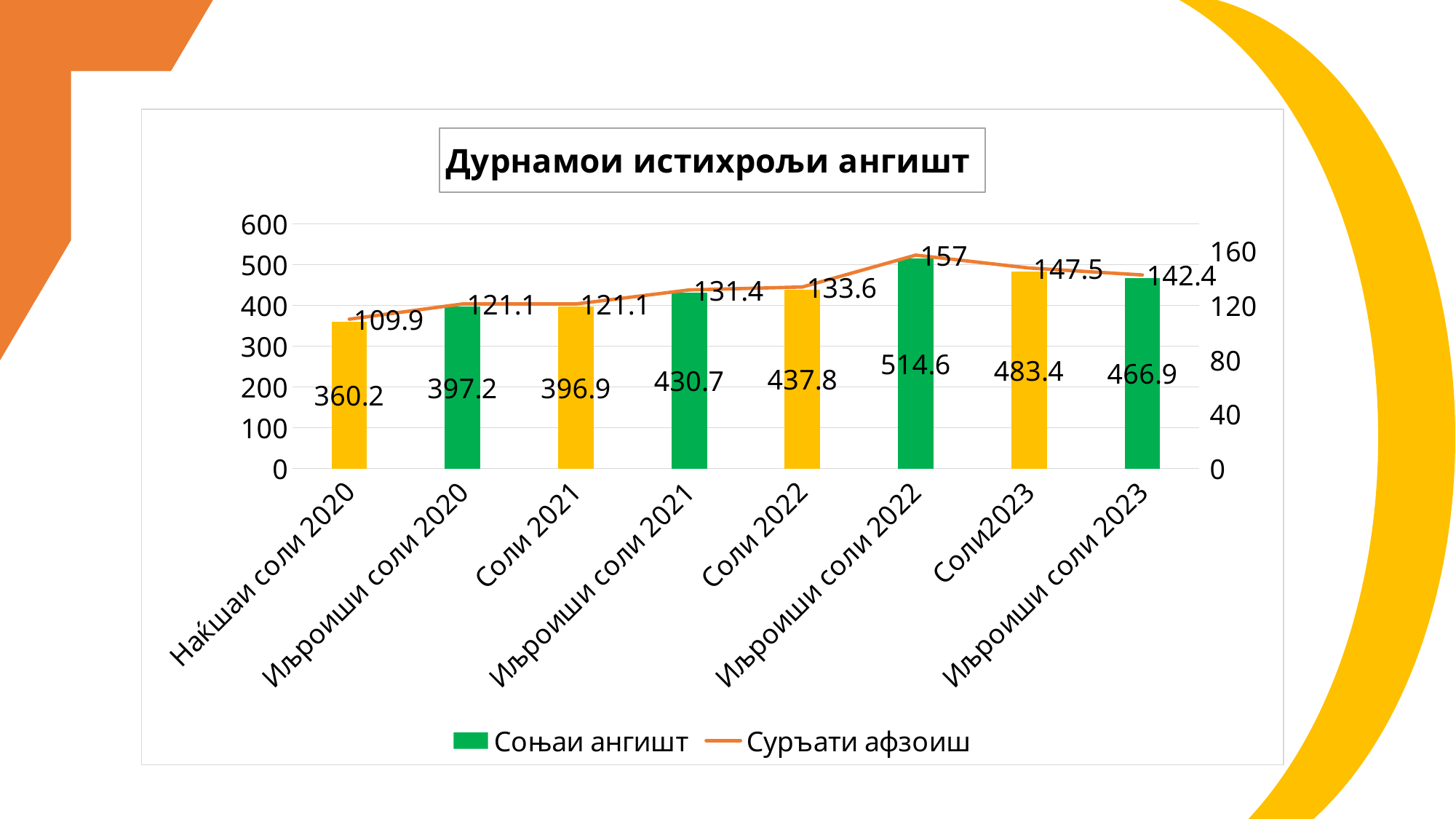
Which category has the highest bar value? Иљроиши соли 2022 What is the title of the chart? Дурнамои истихрољи ангишт Which is larger, the bar value for Иљроиши соли 2021 or for Соли 2022? Соли 2022 What kind of chart is this? Combined bar and line chart What is the bar value for Соли2023? 483.4 How many categories are shown on the x axis? 8 What is the highest value of the Суръати афзоиш line? 157 What is the value of the Суръати афзоиш line at Наќшаи соли 2020? 109.9 How many series does the legend list? 2 Which category has the lowest bar value? Наќшаи соли 2020 What is the difference between the bar values for Иљроиши соли 2022 and Соли2023? 31.2 What is the value of the bar for Иљроиши соли 2022? 514.6